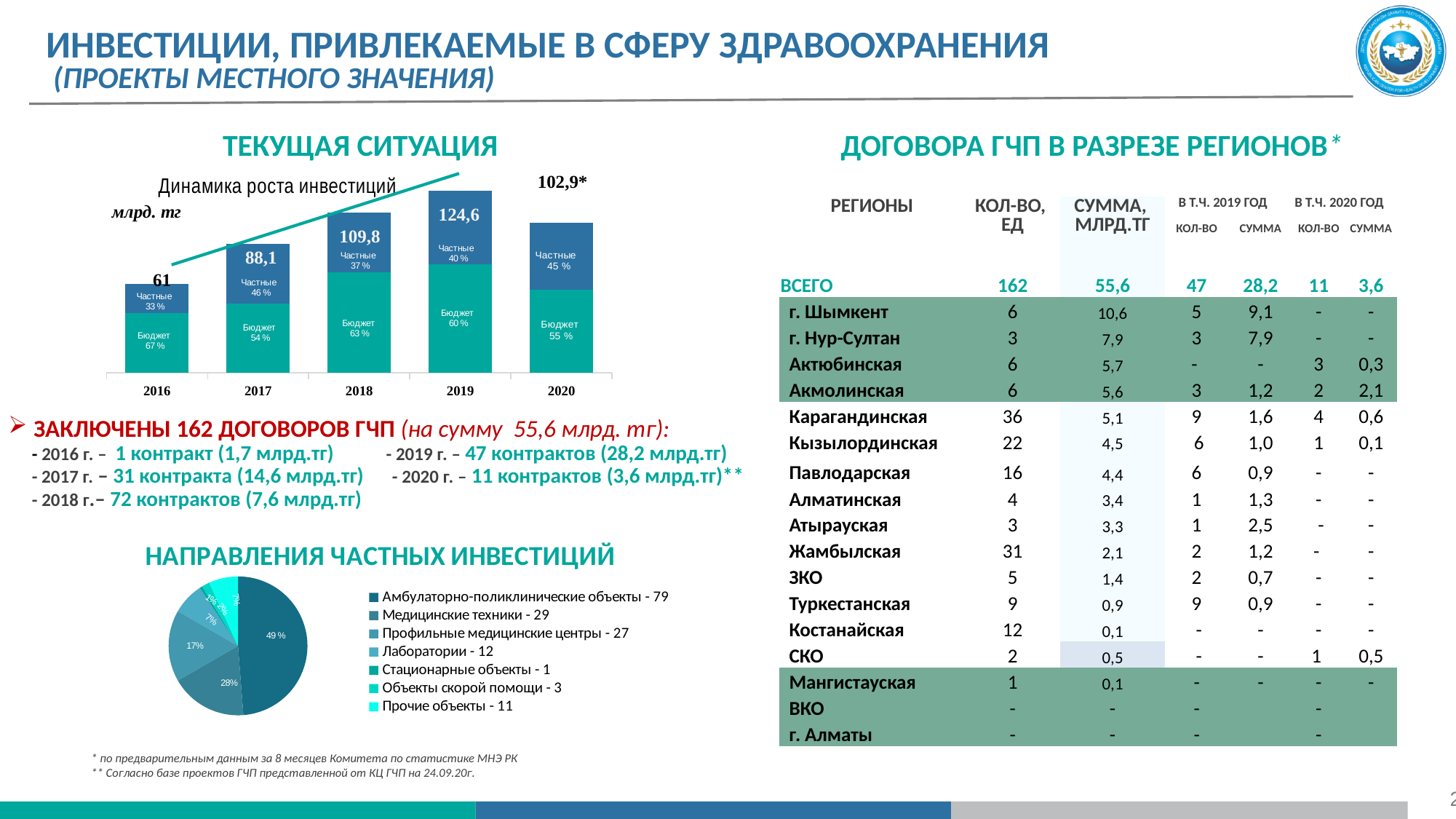
In the pie chart 'Направления частных инвестиций', what share is shown for 'Медицинские техники'? 28% In the chart 'Динамика роста инвестиций', which year has the lowest total value? 2016 In the chart 'Динамика роста инвестиций', what is the total value shown for 2017? 88,1 In the chart 'Динамика роста инвестиций', do the totals rise or fall from 2016 to 2019? rise What type of chart is 'Направления частных инвестиций'? pie chart In the chart 'Динамика роста инвестиций', which total is larger: 2017 or 2020? 2020 How many years are shown on the x axis of the chart 'Динамика роста инвестиций'? 5 In the chart 'Динамика роста инвестиций', what is the total value shown for 2019? 124,6 In the chart 'Динамика роста инвестиций', which year has the highest total value? 2019 In the chart 'Динамика роста инвестиций', what percentage does the 'Частные' segment make up in 2018? 37 % In the chart 'Динамика роста инвестиций', what is the difference between the totals for 2019 and 2018? 14,8 In the chart 'Динамика роста инвестиций', what percentage does the 'Бюджет' segment make up in 2016? 67 %